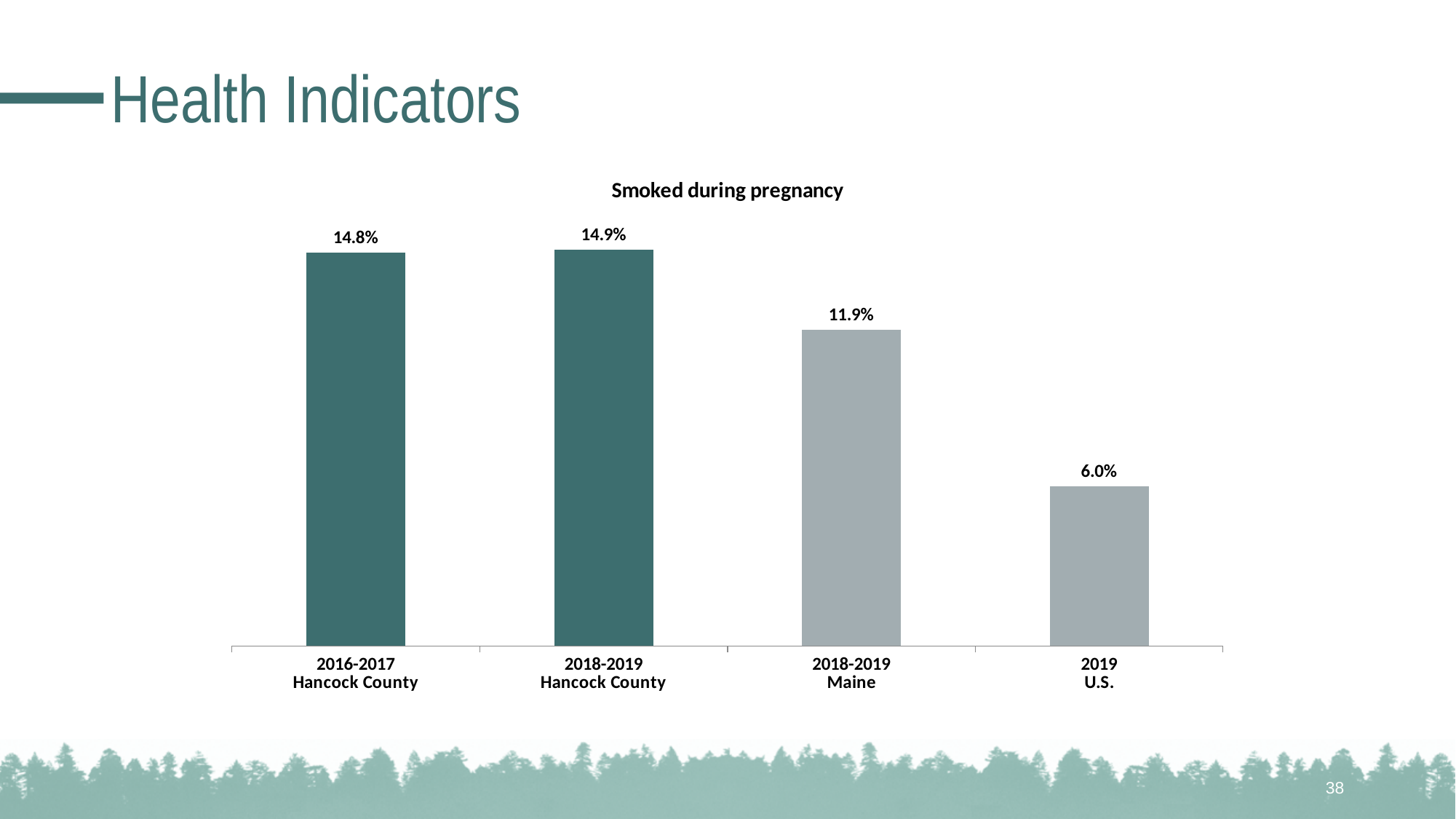
What is the difference between the 2018-2019 Hancock County value and the 2018-2019 Maine value? 3.0% Which category has the lowest value in the Smoked during pregnancy chart? 2019 U.S. What is the value for 2016-2017 Hancock County in the Smoked during pregnancy chart? 14.8% What is the difference between the 2018-2019 Maine value and the 2019 U.S. value? 5.9% What is the value for 2018-2019 Hancock County in the Smoked during pregnancy chart? 14.9% What is the title of the chart on the slide? Smoked during pregnancy What is the value for 2018-2019 Maine in the Smoked during pregnancy chart? 11.9% What kind of chart is shown on the slide? Bar chart What is the value for 2019 U.S. in the Smoked during pregnancy chart? 6.0% Which is larger, the value for 2018-2019 Maine or the value for 2019 U.S.? 2018-2019 Maine How many bars are shown in the Smoked during pregnancy chart? 4 Which category has the highest value in the Smoked during pregnancy chart? 2018-2019 Hancock County